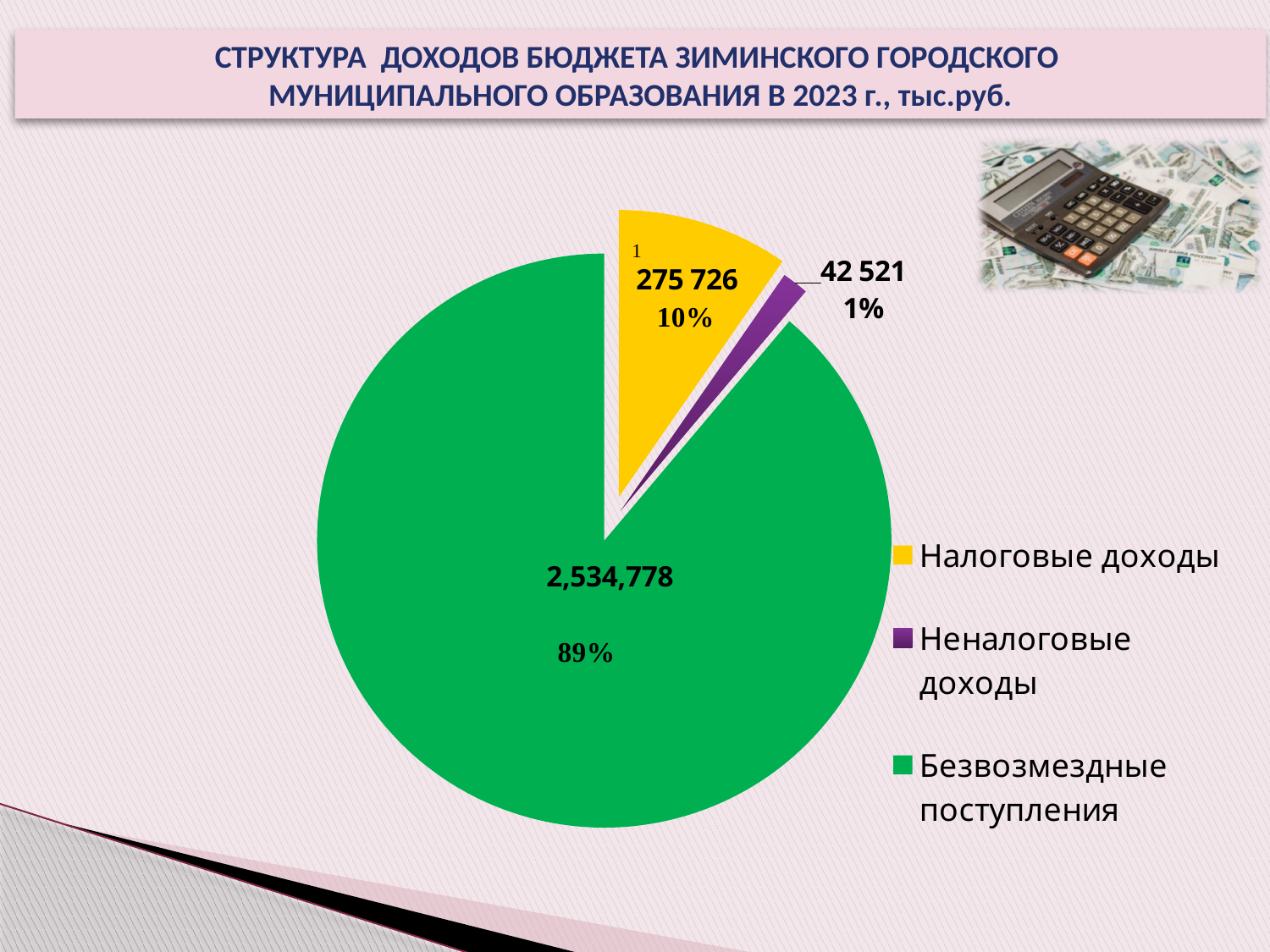
What share of the pie does Неналоговые доходы take? 1% What is the difference between Налоговые доходы and Неналоговые доходы? 233 205 Which is larger, Налоговые доходы or Неналоговые доходы? Налоговые доходы What kind of chart is shown on the slide? pie chart Which category has the smallest slice? Неналоговые доходы What share of the pie does Налоговые доходы take? 10% What is the value for Безвозмездные поступления? 2,534,778 What is the value for Неналоговые доходы? 42 521 What is the value for Налоговые доходы? 275 726 How many categories does the legend list? 3 Which category has the largest slice? Безвозмездные поступления What share of the pie does Безвозмездные поступления take? 89%